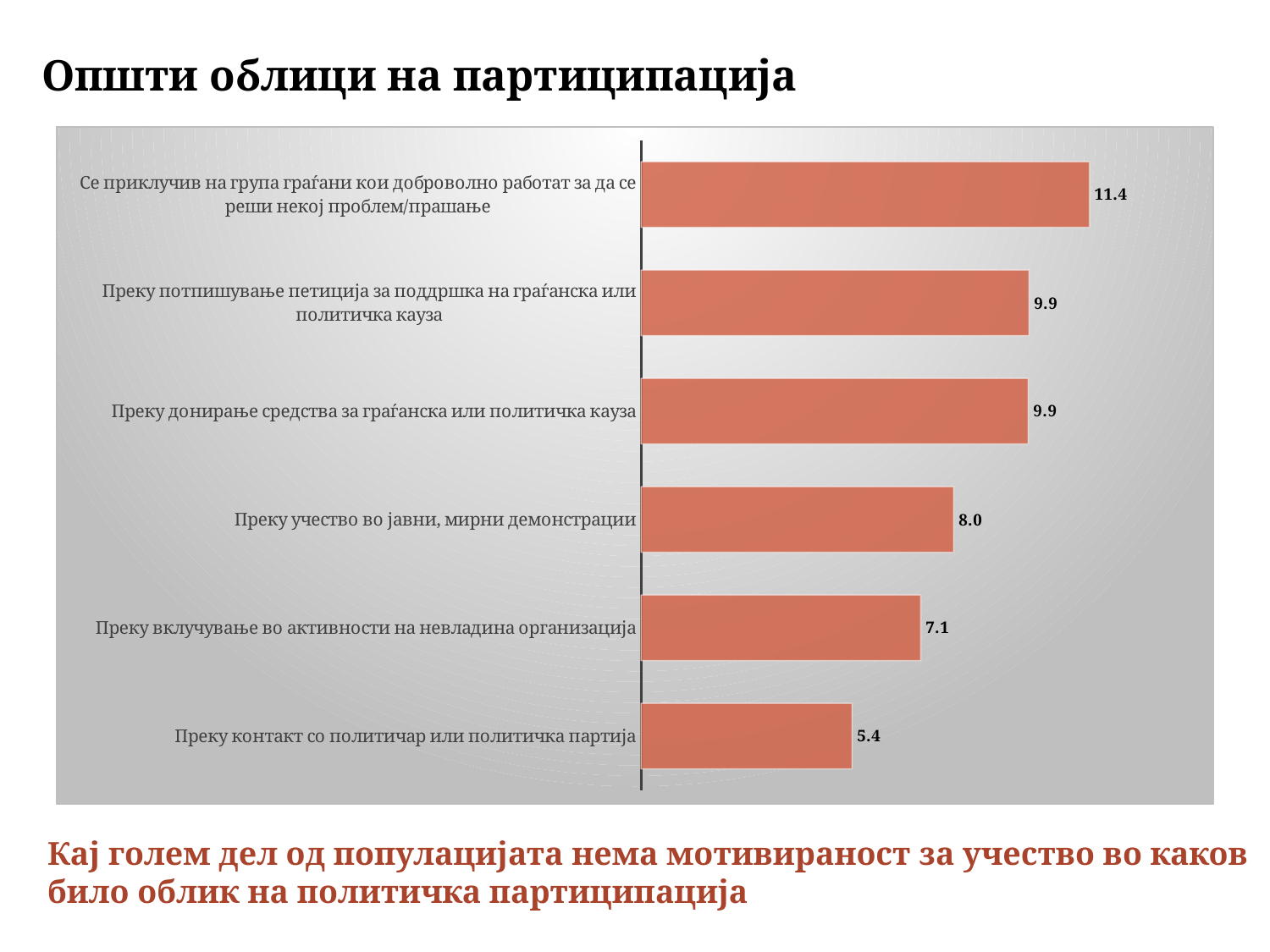
Which is larger: the value for "Преку учество во јавни, мирни демонстрации" or the value for "Преку вклучување во активности на невладина организација"? Преку учество во јавни, мирни демонстрации How many categories are shown in the chart? 6 What kind of chart is shown on the slide? Bar chart What is the value for "Преку учество во јавни, мирни демонстрации"? 8.0 What is the value for "Преку вклучување во активности на невладина организација"? 7.1 What is the difference between the value for "Преку донирање средства за граѓанска или политичка кауза" and the value for "Преку учество во јавни, мирни демонстрации"? 1.9 What is the value for "Преку потпишување петиција за поддршка на граѓанска или политичка кауза"? 9.9 What is the difference between the highest value (11.4) and the lowest value (5.4)? 6.0 What is the value for "Преку контакт со политичар или политичка партија"? 5.4 Which category has the highest value? Се приклучив на група граѓани кои доброволно работат за да се реши некој проблем/прашање What is the title of the slide above the chart? Општи облици на партиципација Which category has the lowest value? Преку контакт со политичар или политичка партија